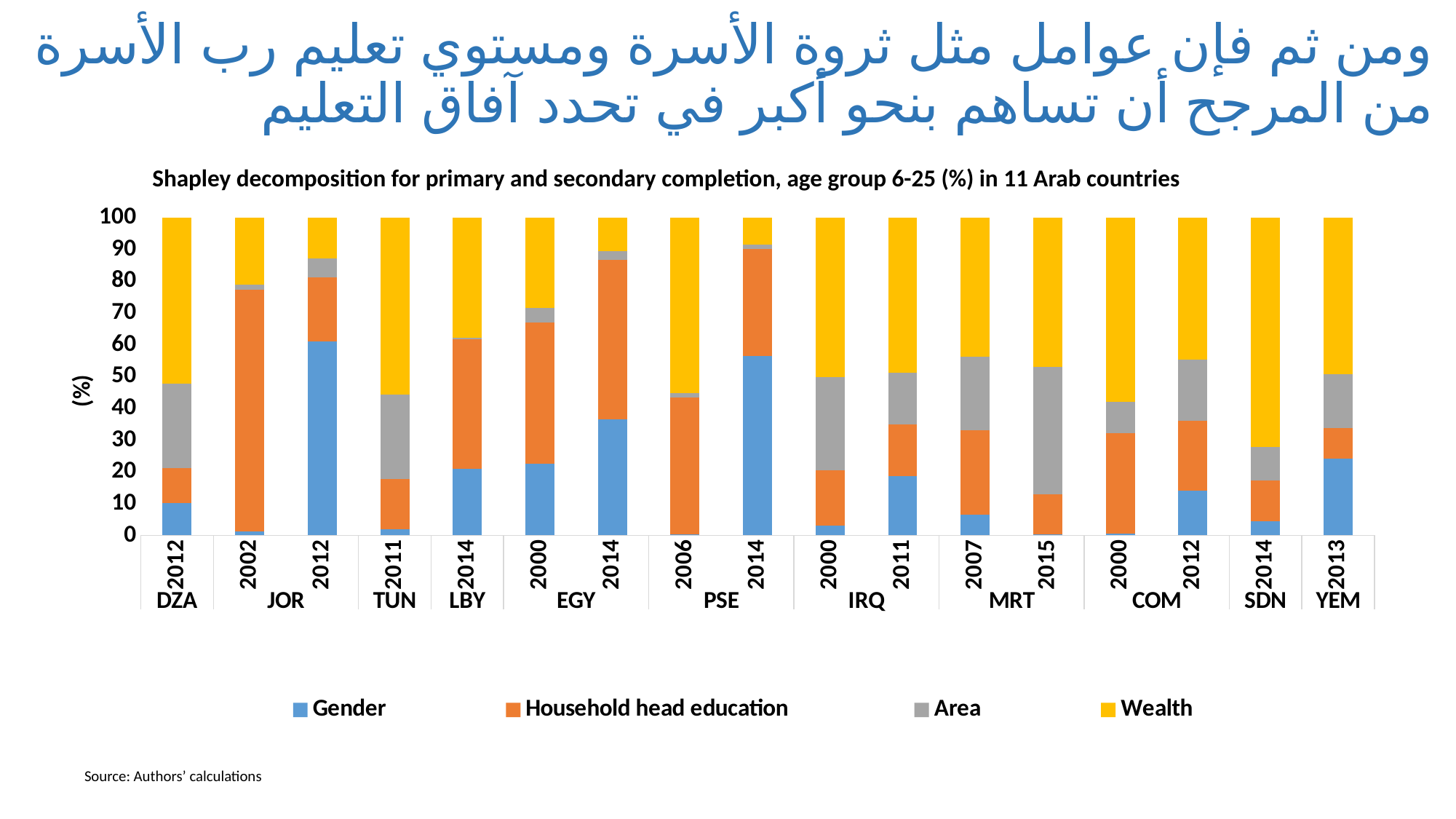
Which bar has the largest Wealth segment? SDN 2014 How many bars are plotted in the chart? 17 What is the title of the chart? Shapley decomposition for primary and secondary completion, age group 6-25 (%) in 11 Arab countries What is the total of the stacked bar for DZA 2012? 100 Is the Gender value for DZA 2012 greater or less than 20? less Is the Household head education value for JOR 2002 greater or less than 50? greater Which two years are shown for EGY? 2000 and 2014 What kind of chart is shown on the slide? Stacked bar chart How many series does the legend list? 4 Is the Gender value for JOR 2012 greater or less than 50? greater Is the Gender segment larger for JOR 2012 or for DZA 2012? JOR 2012